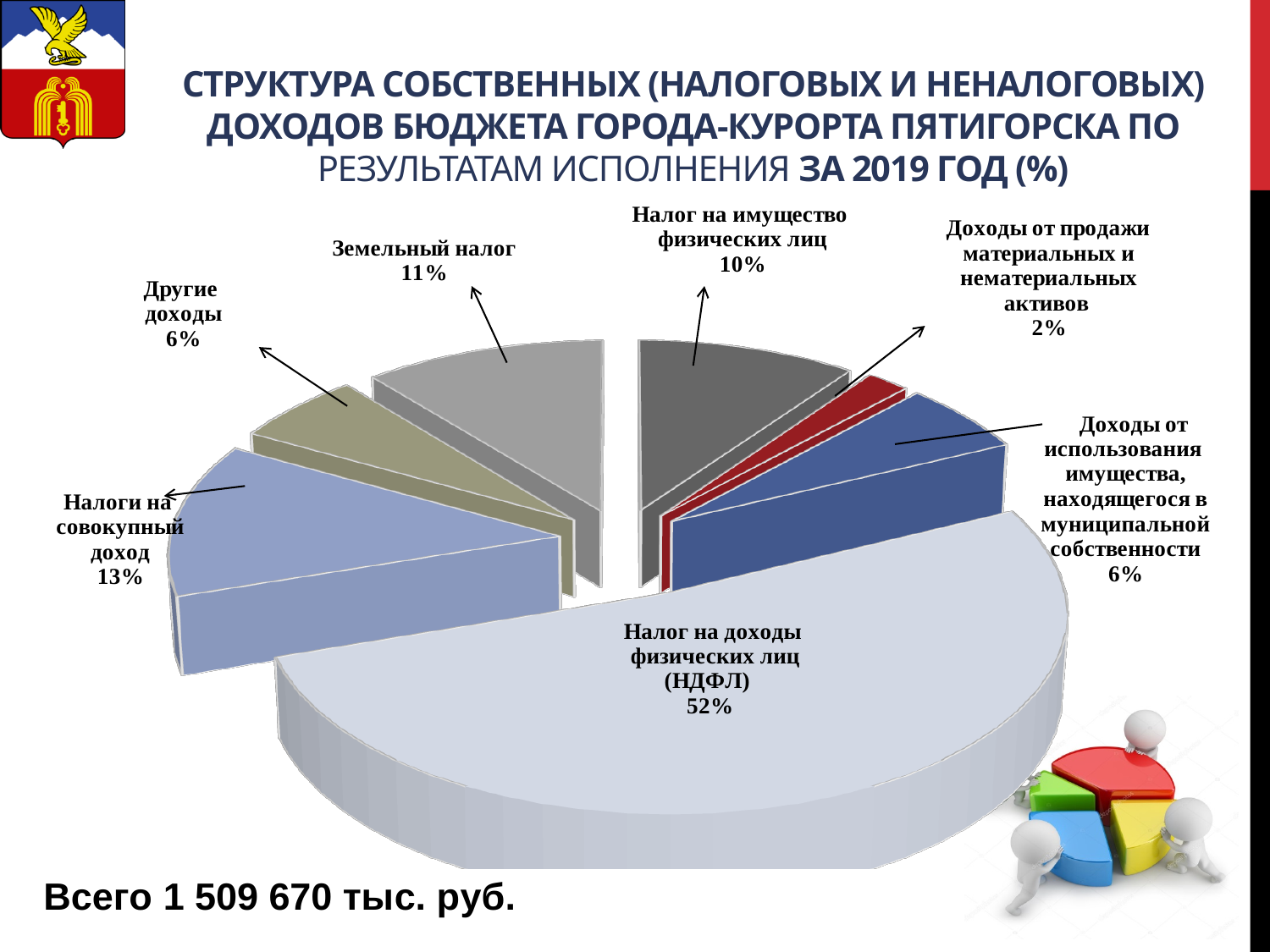
What is the difference between the shares of "Налоги на совокупный доход" and "Земельный налог"? 2% Which is larger: the share of "Земельный налог" or the share of "Налог на имущество физических лиц"? Земельный налог What share of the pie does "Налог на доходы физических лиц (НДФЛ)" have? 52% What kind of chart is shown on the slide? Pie chart How many slices does the pie chart have? 7 What is the value shown for "Налог на имущество физических лиц"? 10% What is the value shown for "Налоги на совокупный доход"? 13% What total amount is stated below the chart? Всего 1 509 670 тыс. руб. What is the value shown for "Земельный налог"? 11% Which category has the largest share of the pie? Налог на доходы физических лиц (НДФЛ) Which category has the smallest share of the pie? Доходы от продажи материальных и нематериальных активов What is the value shown for "Доходы от продажи материальных и нематериальных активов"? 2%